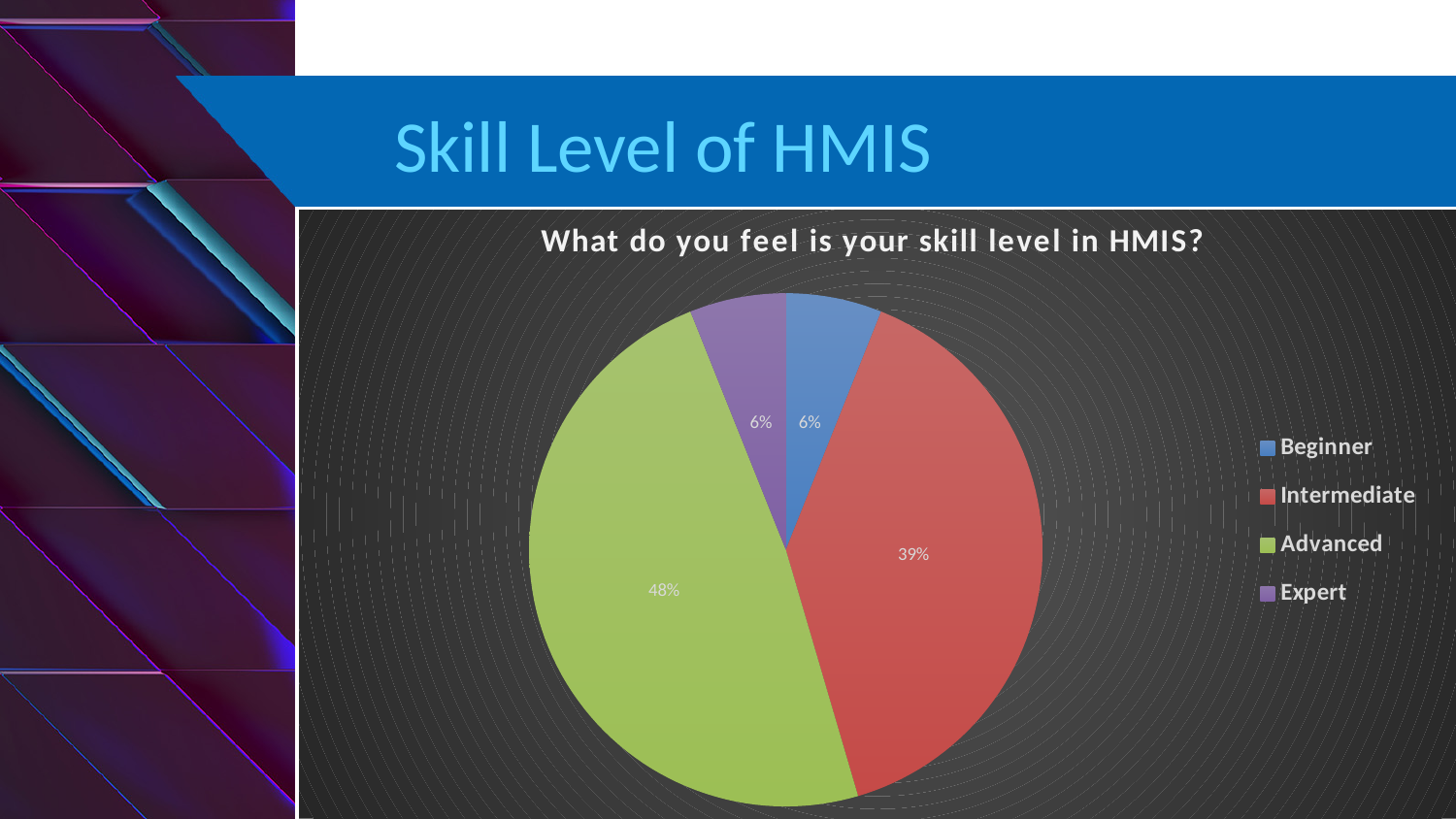
What colour is the Advanced slice? green What share of the pie is Intermediate? 39% What share of the pie is Beginner? 6% What is the difference between the Advanced and Intermediate shares? 9% How many entries does the legend list? 4 Which skill level has the largest share of the pie? Advanced How many slices does the pie chart have? 4 Which is larger, the Intermediate share or the Beginner share? Intermediate What share of the pie is Expert? 6% What share of the pie is Advanced? 48% What is the chart's title? What do you feel is your skill level in HMIS? What kind of chart is shown on the slide? pie chart